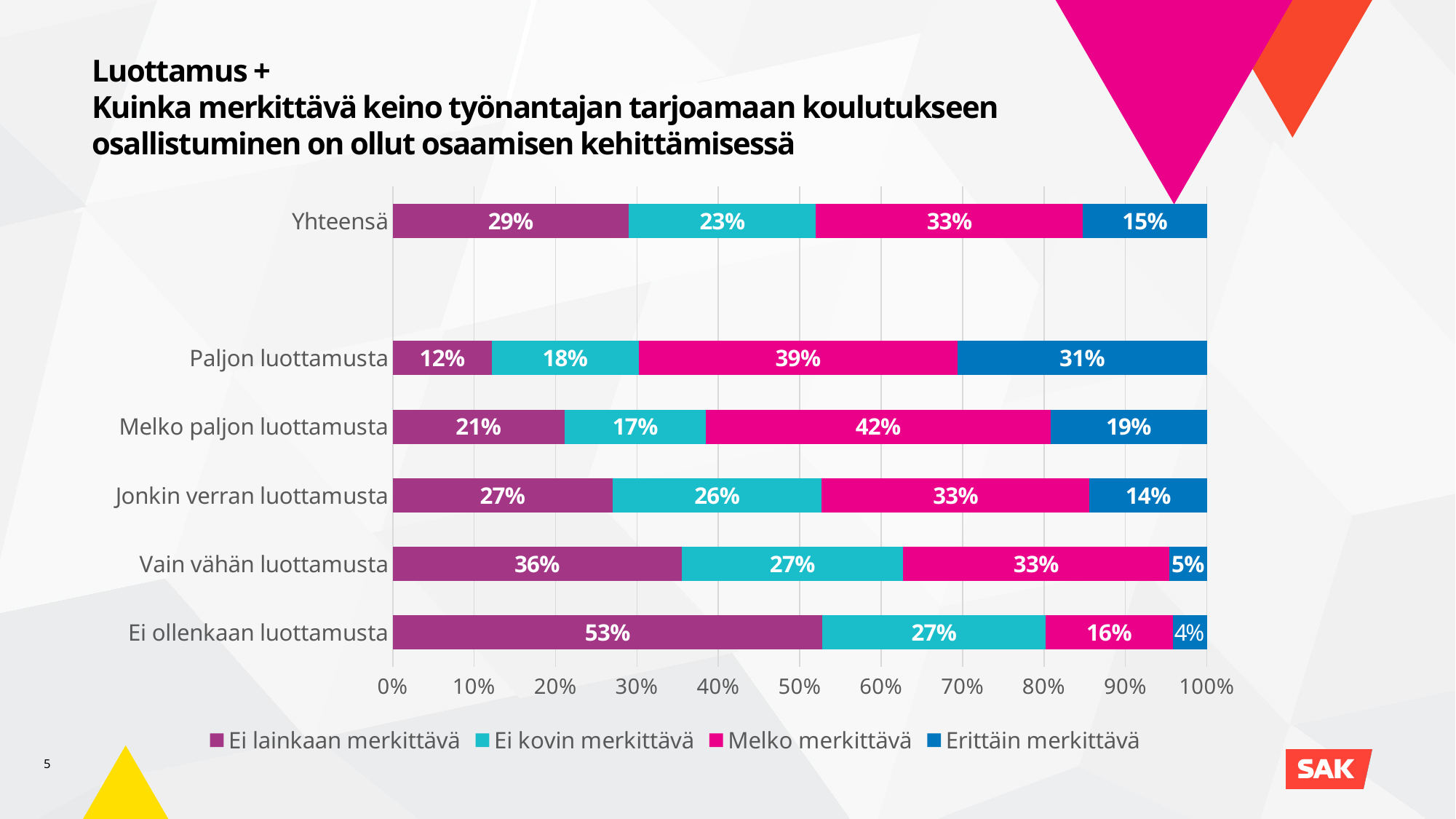
What is the value of 'Ei lainkaan merkittävä' for 'Yhteensä'? 29% How many series does the legend list? 4 Which legend entry is shown in dark blue? Erittäin merkittävä What is the value of 'Melko merkittävä' for 'Melko paljon luottamusta'? 42% What is the value of 'Erittäin merkittävä' for 'Paljon luottamusta'? 31% What kind of chart is shown on the slide? stacked bar chart How many categories are shown on the vertical axis of the chart? 6 What is the total of the stacked bar for 'Melko paljon luottamusta'? 99% What is the difference between the 'Ei lainkaan merkittävä' values for 'Ei ollenkaan luottamusta' and 'Paljon luottamusta'? 41% Which is larger: the 'Melko merkittävä' value for 'Paljon luottamusta' or for 'Jonkin verran luottamusta'? Paljon luottamusta Which category has the lowest value for 'Erittäin merkittävä'? Ei ollenkaan luottamusta Which category has the highest value for 'Ei lainkaan merkittävä'? Ei ollenkaan luottamusta